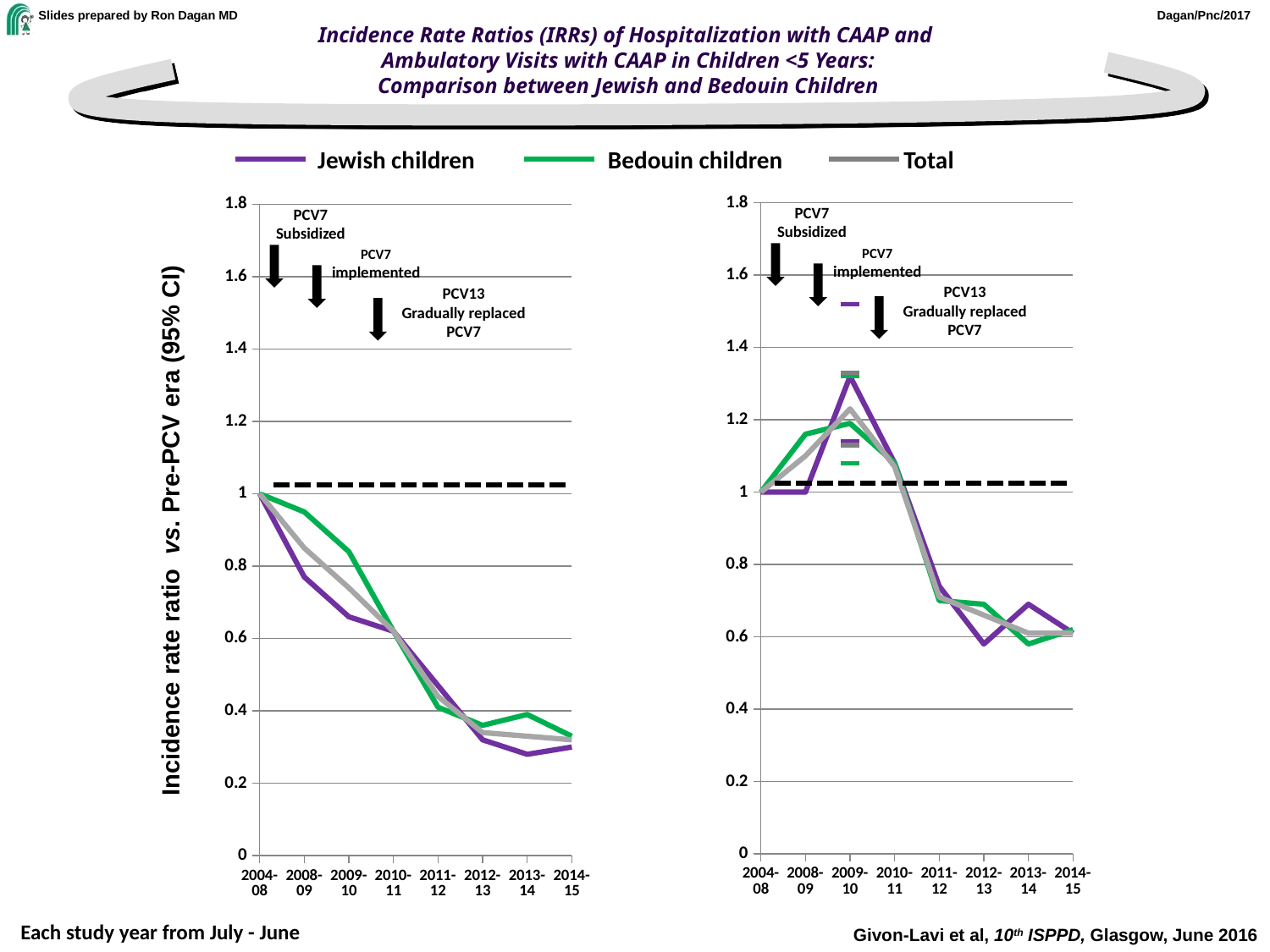
In the right chart, is the value for Jewish children in 2009-10 greater or less than 1.2? greater In the left chart, do the values for Total rise or fall from 2004-08 to 2014-15? fall In the left chart, what is the incidence rate ratio for Jewish children in 2004-08? 1 In the left chart, is the value for Jewish children in 2013-14 greater or less than 0.4? less How many series does the legend list? 3 In the right chart, which study year has the highest value for Jewish children? 2009-10 Which colour is used for the Bedouin children series in the legend? green In the left chart, which is larger in 2008-09: the value for Jewish children or for Bedouin children? Bedouin children In the right chart, do the values for Total rise or fall from 2010-11 to 2014-15? fall How many study years are plotted along the x axis of the right chart? 8 What kind of chart is the left chart on the slide? line chart In the right chart, which is larger in 2009-10: the value for Jewish children or for Bedouin children? Jewish children